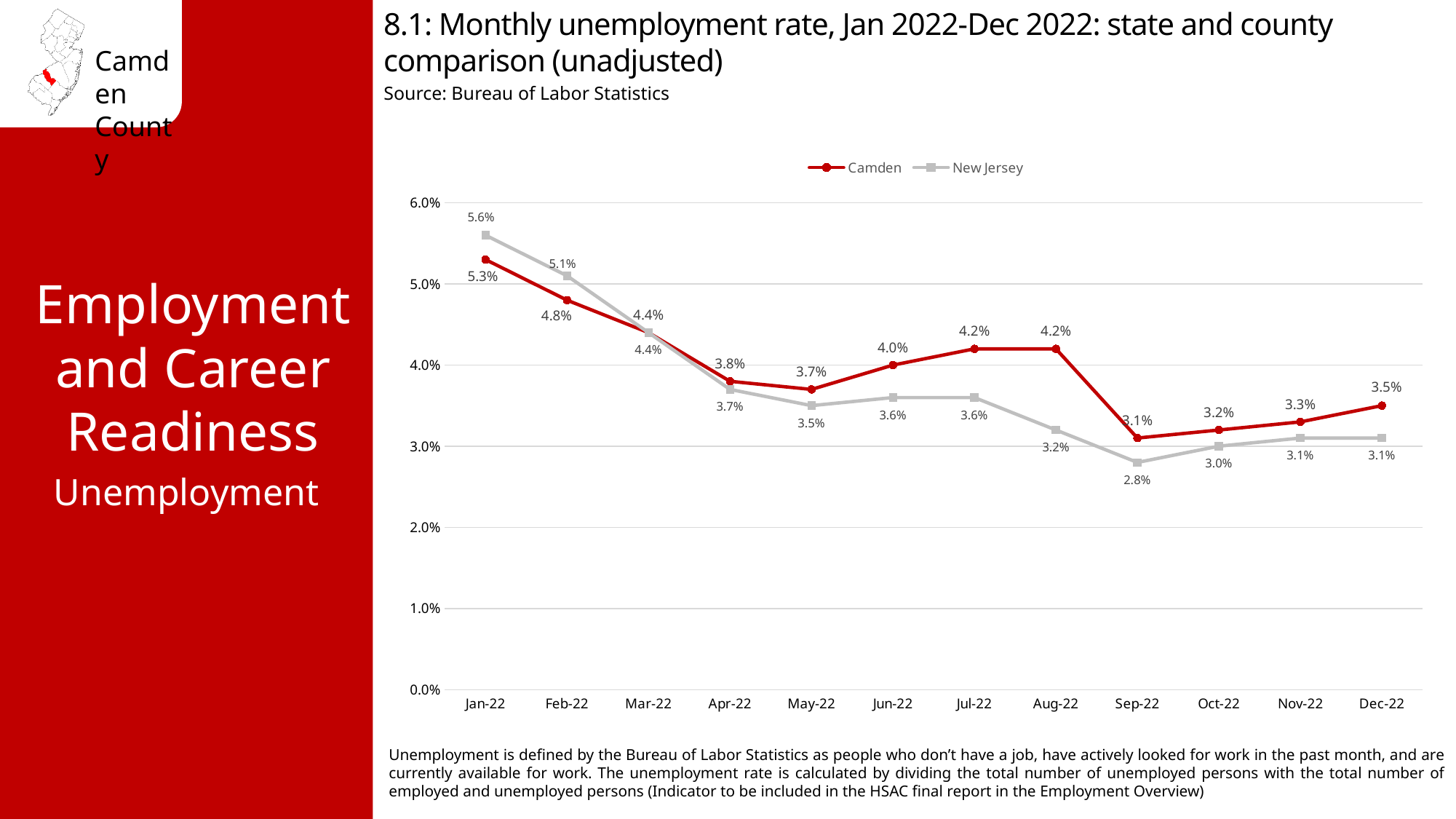
Did New Jersey's unemployment rate rise or fall from Jan-22 to May-22? Fall What is the source cited for the chart? Bureau of Labor Statistics How many series does the legend list? 2 What was New Jersey's unemployment rate in Jan-22? 5.6% Which had the higher unemployment rate in Feb-22, Camden or New Jersey? New Jersey How many months are shown on the x axis? 12 What kind of chart is shown on the slide? Line chart In which month was New Jersey's unemployment rate lowest? Sep-22 What was New Jersey's unemployment rate in Sep-22? 2.8% In which month was Camden's unemployment rate highest? Jan-22 What is the difference between Camden's and New Jersey's unemployment rates in Dec-22? 0.4% What was Camden's unemployment rate in Jul-22? 4.2%